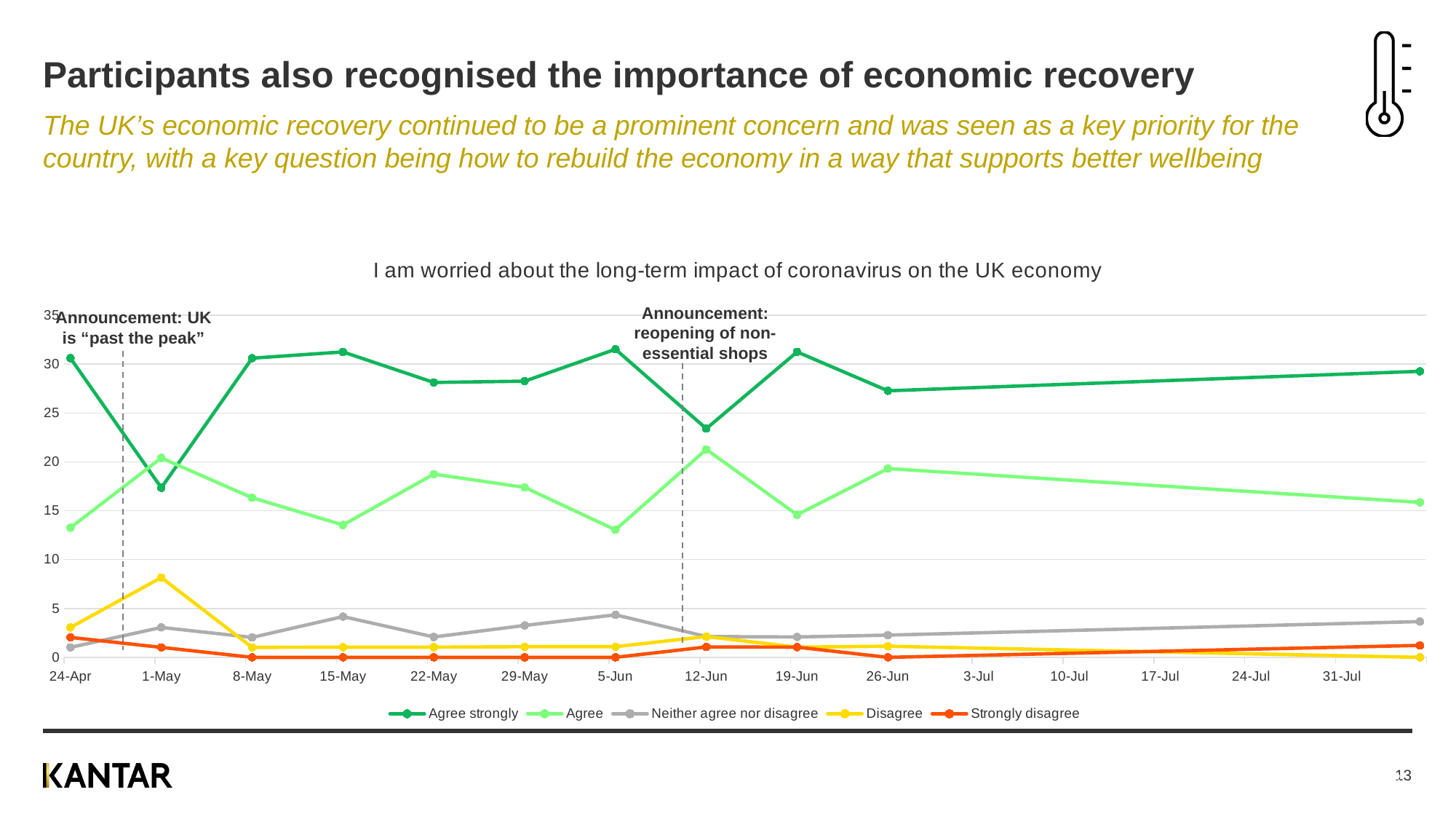
Does the Agree strongly series rise or fall between 1-May and 8-May? Rise At which date does the Agree strongly series reach its lowest value? 1-May Is the value for Agree at 5-Jun greater or less than 15? less Is the value for Agree strongly at 1-May greater or less than 20? less At which date does the Disagree series reach its highest value? 1-May How many series does the chart's legend list? 5 Is the value for Agree strongly at 24-Apr greater or less than 30? greater Which series has the highest values across most of the chart? Agree strongly What kind of chart is shown on the slide? Line chart What is the title of the chart? I am worried about the long-term impact of coronavirus on the UK economy At 1-May, which is higher: Agree or Agree strongly? Agree